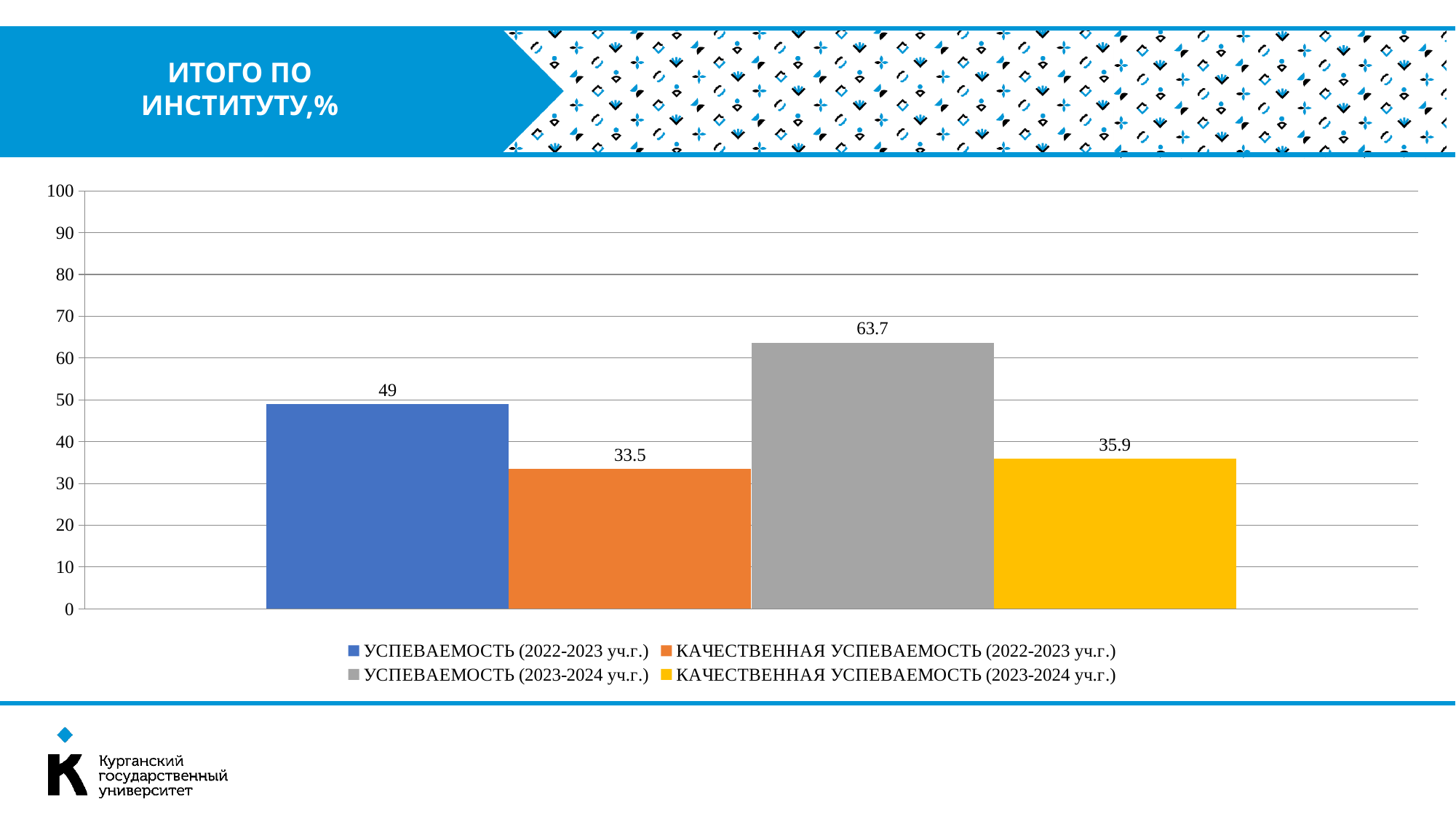
What is the difference between УСПЕВАЕМОСТЬ (2023-2024 уч.г.) and УСПЕВАЕМОСТЬ (2022-2023 уч.г.)? 14.7 What is the title of the slide? ИТОГО ПО ИНСТИТУТУ,% What is the difference between КАЧЕСТВЕННАЯ УСПЕВАЕМОСТЬ (2023-2024 уч.г.) and КАЧЕСТВЕННАЯ УСПЕВАЕМОСТЬ (2022-2023 уч.г.)? 2.4 Which series has the lowest value? КАЧЕСТВЕННАЯ УСПЕВАЕМОСТЬ (2022-2023 уч.г.) How many series does the legend list? 4 What kind of chart is shown on the slide? Bar chart Which series has the highest value? УСПЕВАЕМОСТЬ (2023-2024 уч.г.) What is the value for УСПЕВАЕМОСТЬ (2023-2024 уч.г.)? 63.7 What is the value for КАЧЕСТВЕННАЯ УСПЕВАЕМОСТЬ (2022-2023 уч.г.)? 33.5 What is the value for КАЧЕСТВЕННАЯ УСПЕВАЕМОСТЬ (2023-2024 уч.г.)? 35.9 What is the value for УСПЕВАЕМОСТЬ (2022-2023 уч.г.)? 49 Which is larger: УСПЕВАЕМОСТЬ (2022-2023 уч.г.) or КАЧЕСТВЕННАЯ УСПЕВАЕМОСТЬ (2023-2024 уч.г.)? УСПЕВАЕМОСТЬ (2022-2023 уч.г.)